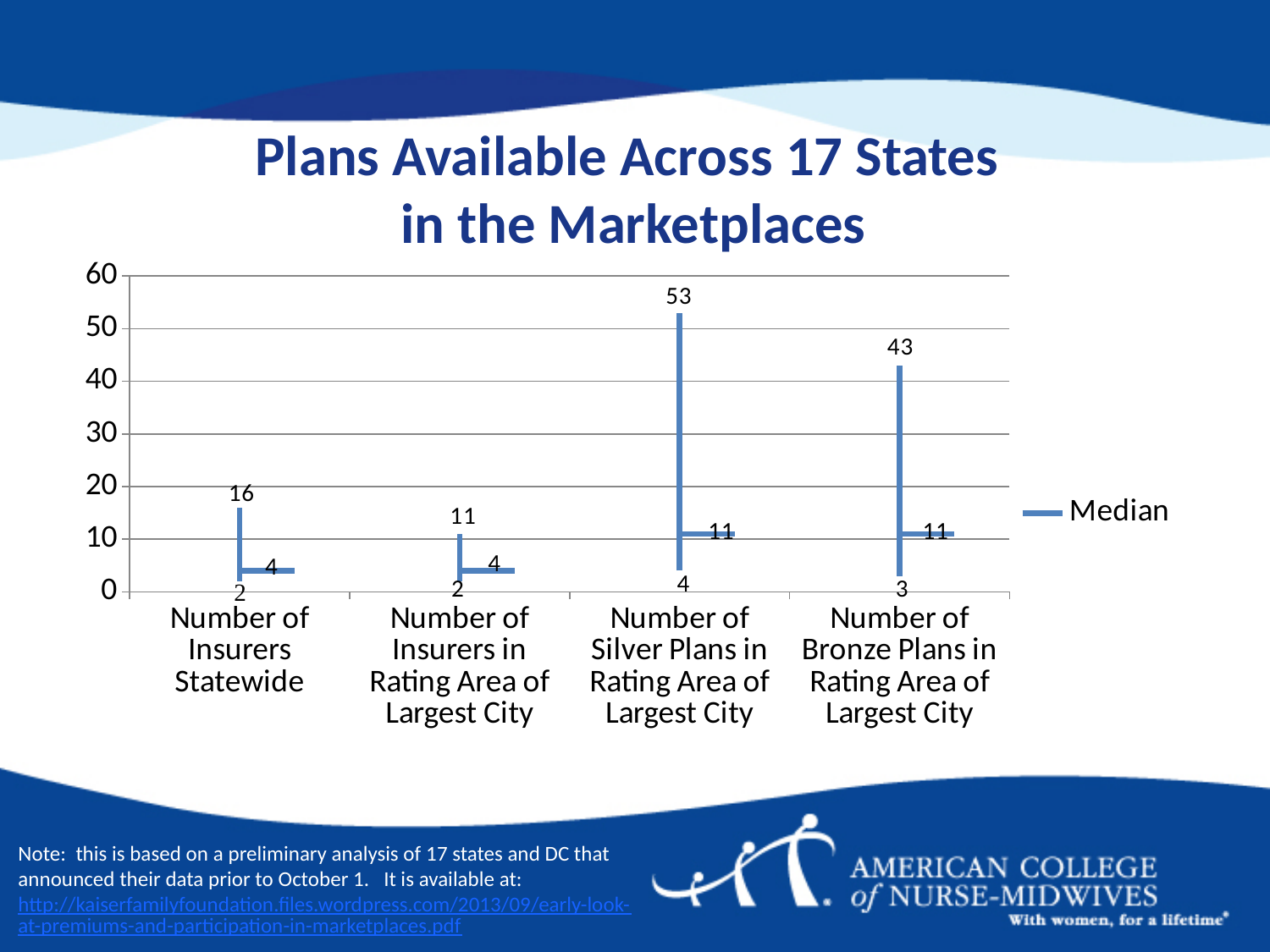
What is the highest value shown for Number of Insurers in Rating Area of Largest City? 11 How many categories are shown on the x axis? 4 What is the lowest value shown for Number of Bronze Plans in Rating Area of Largest City? 3 Which has a higher top value: Number of Insurers Statewide or Number of Insurers in Rating Area of Largest City? Number of Insurers Statewide What is the title of the chart? Plans Available Across 17 States in the Marketplaces What is the difference between the top values for Number of Silver Plans and Number of Bronze Plans in Rating Area of Largest City? 10 What is the median value for Number of Silver Plans in Rating Area of Largest City? 11 What is the difference between the highest and lowest values for Number of Insurers Statewide? 14 What is the median value for Number of Insurers Statewide? 4 How many series does the legend list? 1 Which category has the highest top value? Number of Silver Plans in Rating Area of Largest City What is the highest value shown for Number of Silver Plans in Rating Area of Largest City? 53